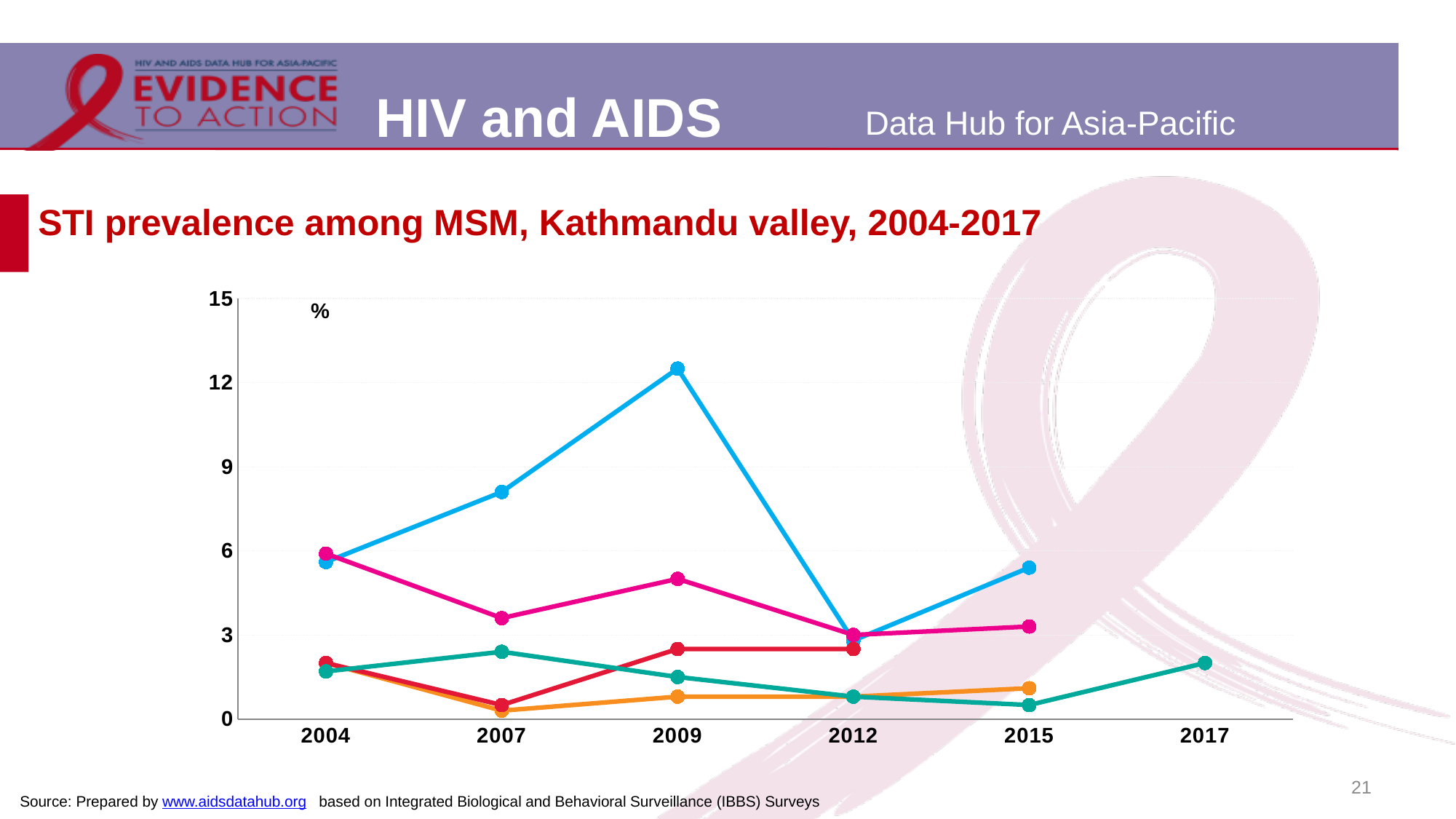
Is the value of the orange line in 2007 greater or less than 3? less Is the value of the green line in 2017 greater or less than 3? less Does the blue line rise or fall between 2009 and 2012? fall Is the value of the pink line in 2004 greater or less than 3? greater In 2009, which line has the larger value, the blue line or the pink line? blue line What is the title of the chart on the slide? STI prevalence among MSM, Kathmandu valley, 2004-2017 How many years are shown on the x axis of the chart? 6 What unit is indicated on the y axis of the chart? % What kind of chart is shown on the slide? line chart In which year does the blue line reach its highest value? 2009